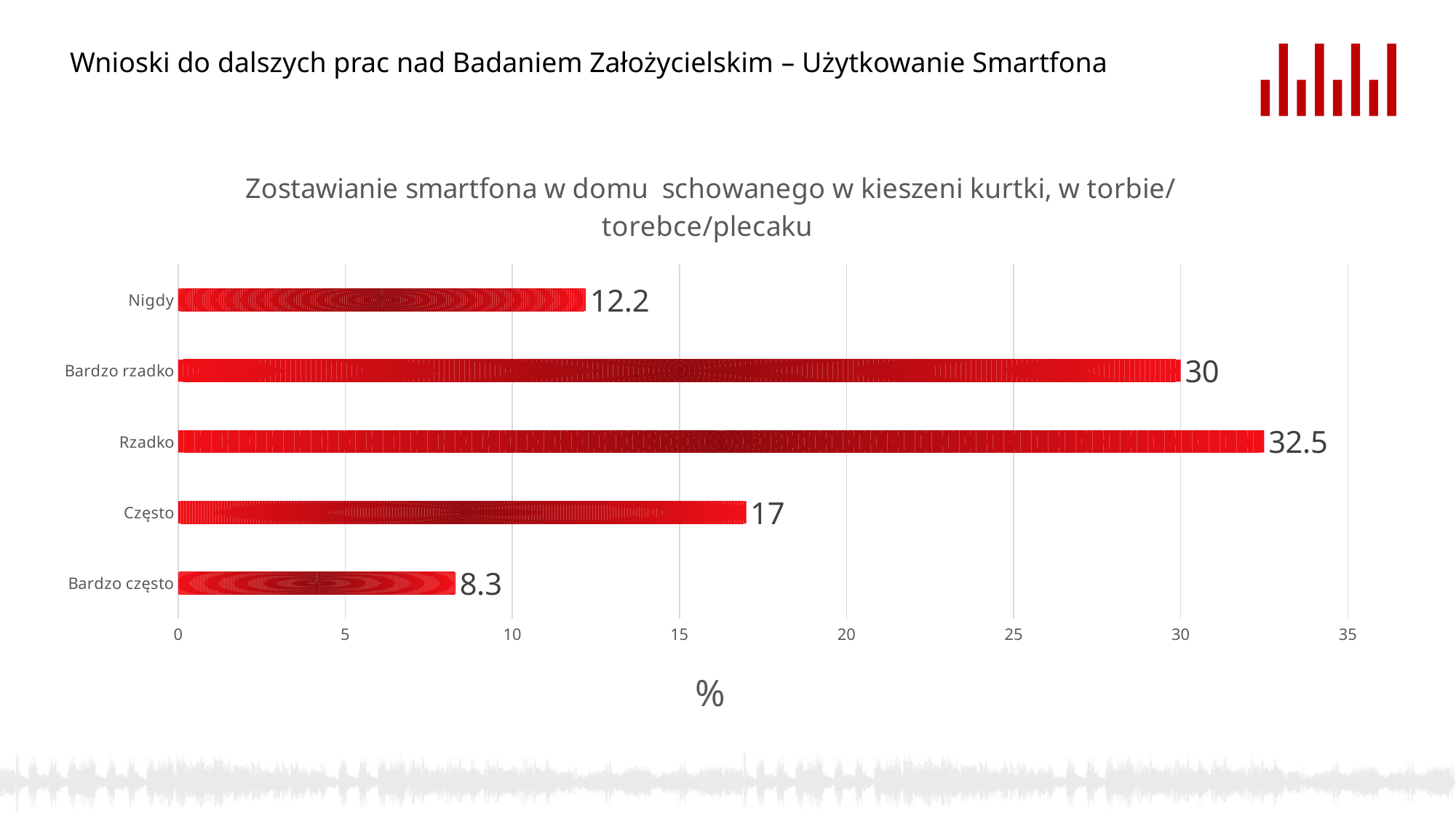
Which category has the lowest value? Bardzo często How many categories are shown in the chart? 5 What is the value for Często? 17 What is the value for Nigdy? 12.2 What is the value for Bardzo często? 8.3 Which is larger, the value for Często or the value for Nigdy? Często What kind of chart is shown on the slide? bar chart What is the difference between the values for Często and Nigdy? 4.8 What is the difference between the values for Rzadko and Bardzo rzadko? 2.5 What is the value for Rzadko? 32.5 What unit is shown on the horizontal axis label? % Which category has the highest value? Rzadko